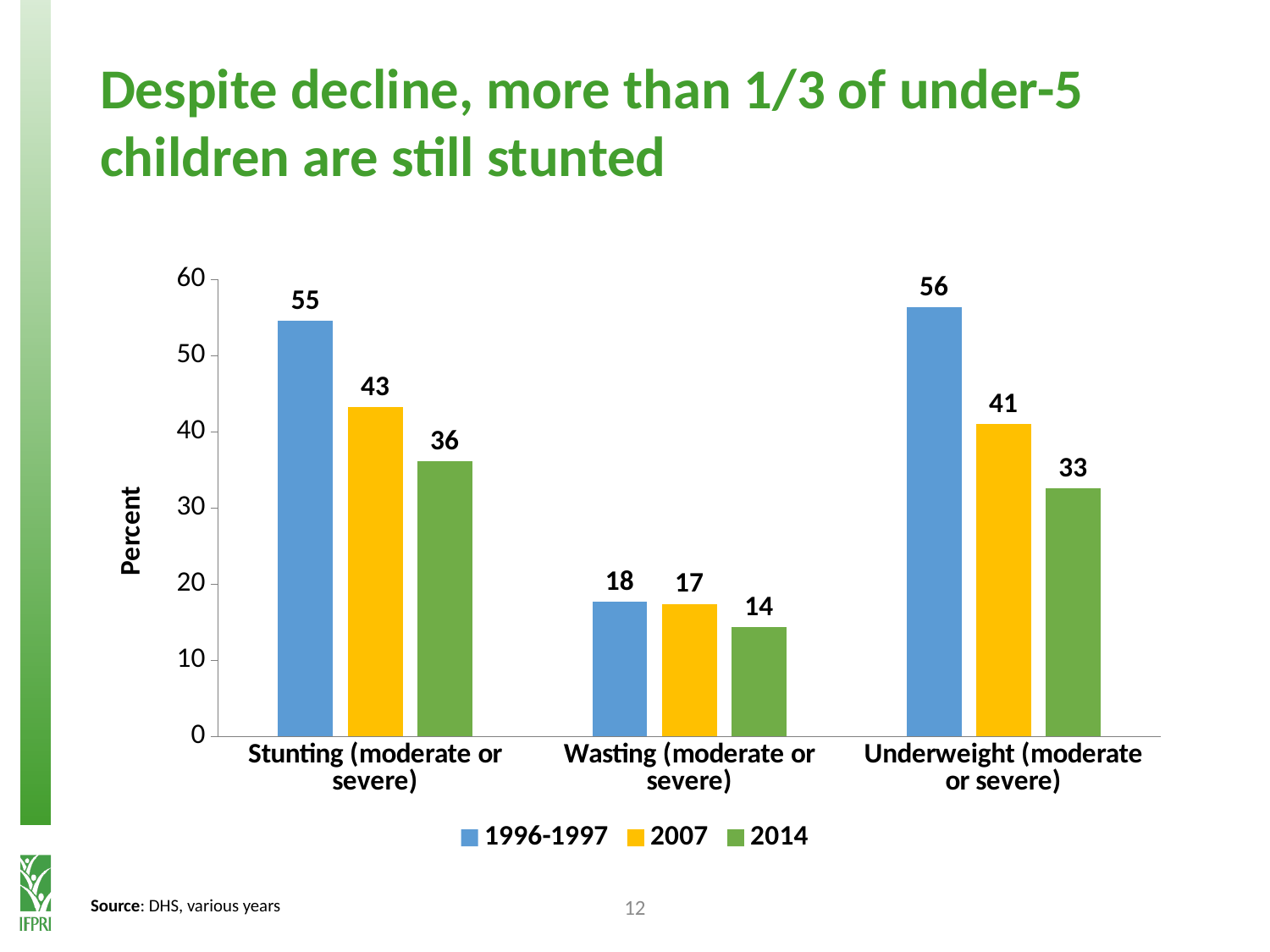
What is the label of the y axis? Percent What kind of chart is shown on the slide? Bar chart What is the difference between the 1996-1997 and 2014 values for Stunting (moderate or severe)? 19 Which category has the lowest value in the 1996-1997 series? Wasting (moderate or severe) How many series does the legend list? 3 Which is larger: the 1996-1997 value for Stunting (moderate or severe) or the 1996-1997 value for Underweight (moderate or severe)? Underweight (moderate or severe) What is the difference between the 2007 and 2014 values for Underweight (moderate or severe)? 8 Which category has the highest value in the 2014 series? Stunting (moderate or severe) How many categories are shown on the x axis? 3 What is the value for Wasting (moderate or severe) in 2007? 17 What is the value for Stunting (moderate or severe) in 2014? 36 What is the value for Underweight (moderate or severe) in 1996-1997? 56